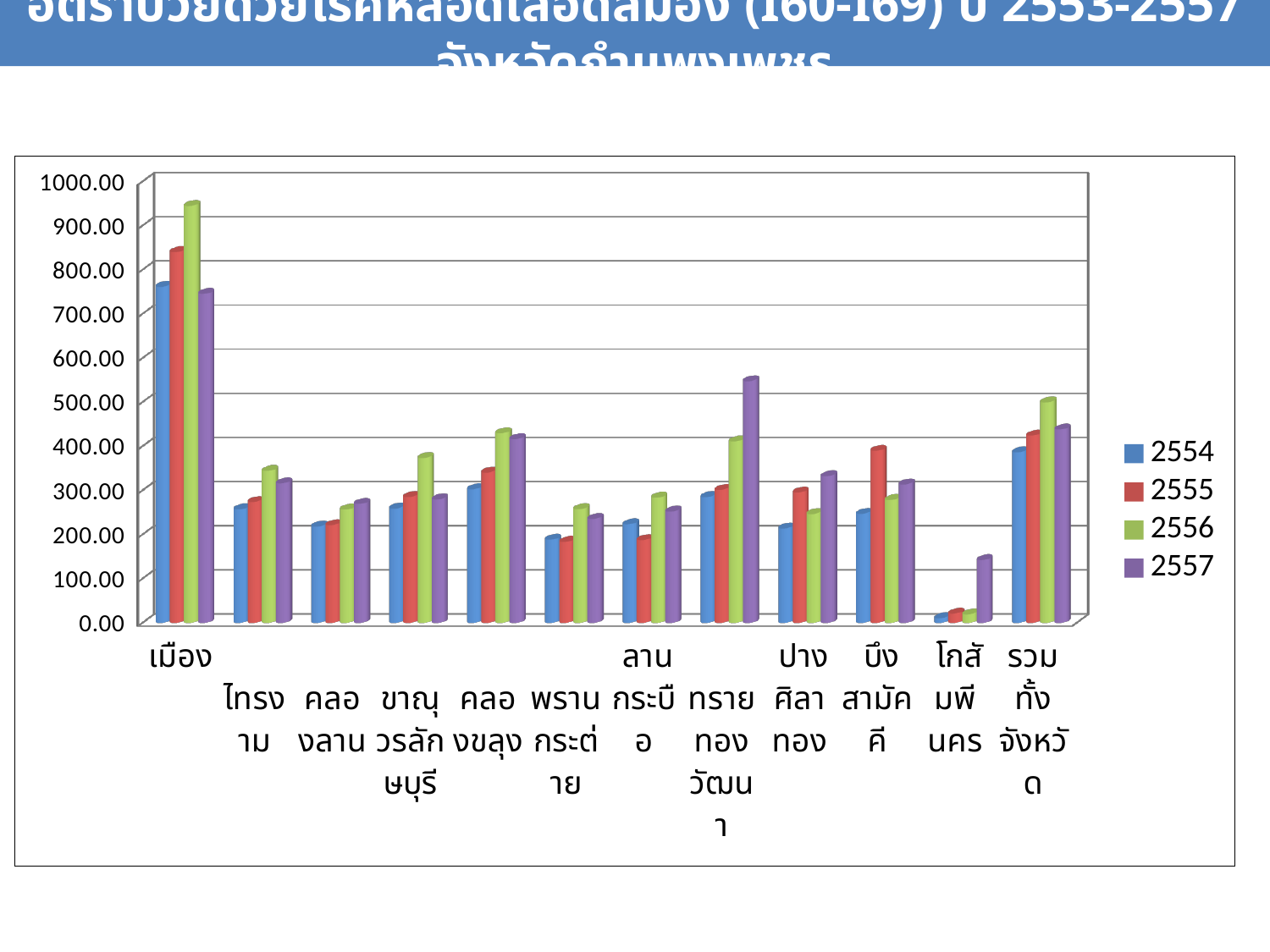
Which category has the lowest value for the 2554 series? โกสัมพีนคร Is the 2557 value for โกสัมพีนคร greater or less than 100? greater How many categories are shown along the x axis? 12 Is the 2555 value for บึงสามัคคี greater or less than 300? greater For ทรายทองวัฒนา, do the values rise or fall from 2554 to 2557? rise For เมือง, which series has the larger value, 2556 or 2557? 2556 What kind of chart is shown on the slide? bar chart Is the 2556 value for เมือง greater or less than 900? greater Which colour represents the 2554 series in the legend? blue Which category has the highest value for the 2556 series? เมือง For ทรายทองวัฒนา, which series has the larger value, 2556 or 2557? 2557 How many series does the legend list? 4